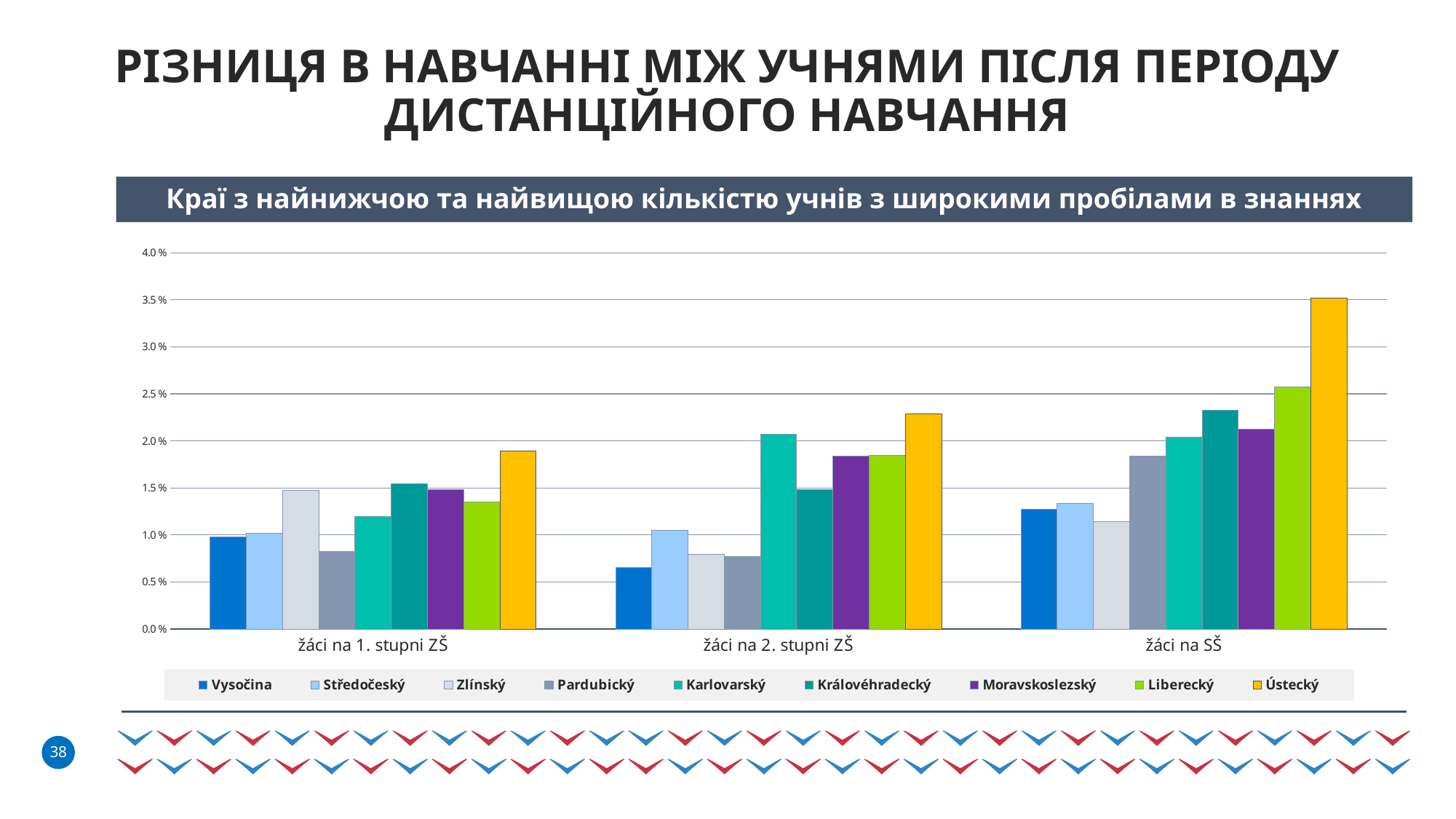
How many categories are shown on the x axis? 3 Is the value for Vysočina for žáci na 2. stupni ZŠ greater or less than 1.0 %? less How many series does the legend list? 9 Do the values for Ústecký rise or fall from žáci na 1. stupni ZŠ to žáci na SŠ? rise For žáci na 2. stupni ZŠ, which is larger: Karlovarský or Královéhradecký? Karlovarský Which region has the highest value for žáci na SŠ? Ústecký What colour represents Ústecký in the legend? Yellow Is the value for Ústecký for žáci na SŠ greater or less than 3.0 %? greater Is the value for Pardubický for žáci na 1. stupni ZŠ greater or less than 1.0 %? less What kind of chart is shown on the slide? Bar chart Which region has the lowest value for žáci na 2. stupni ZŠ? Vysočina Which region has the highest value for žáci na 1. stupni ZŠ? Ústecký